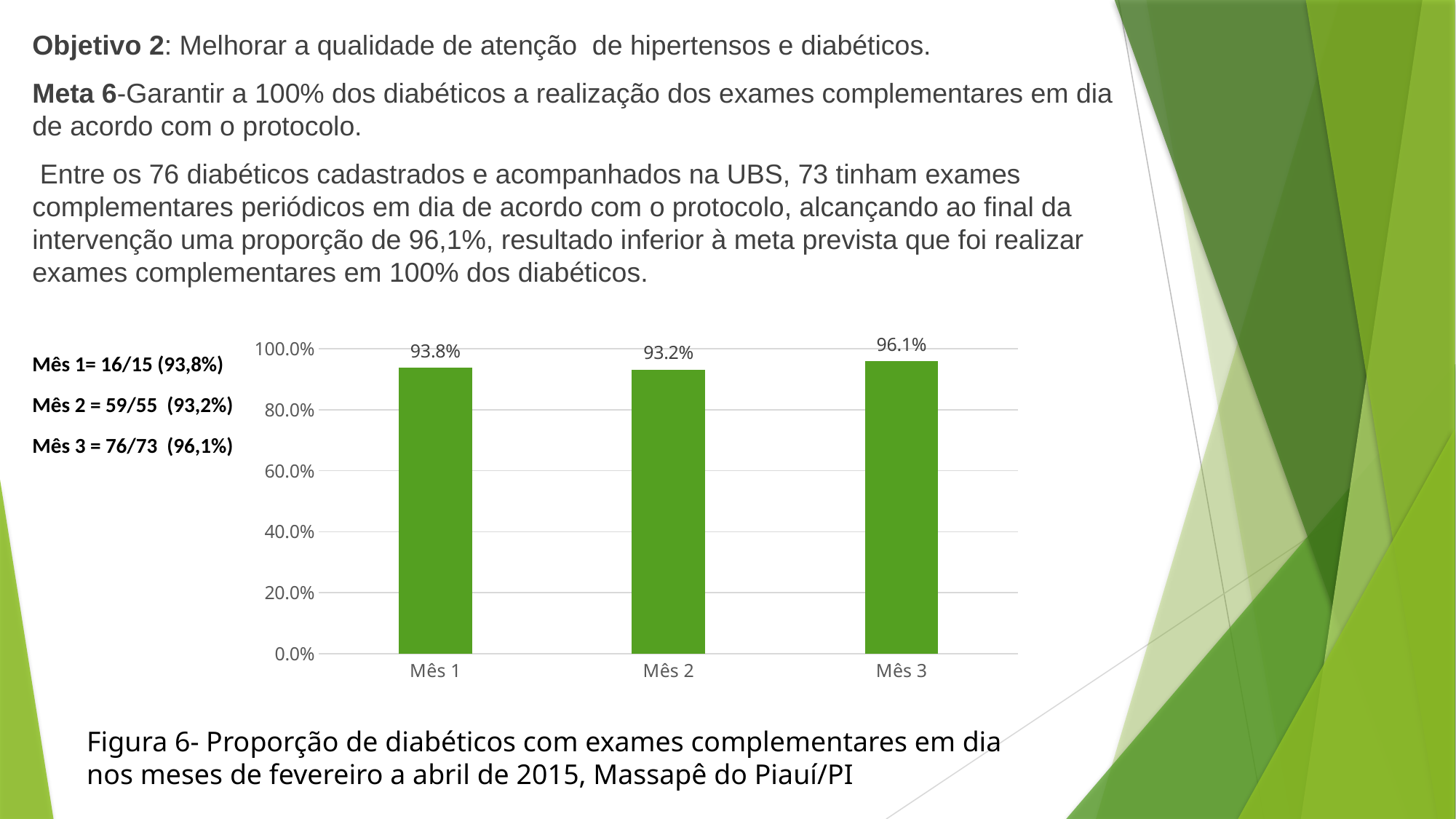
How many months are shown on the x axis? 3 What is the value for Mês 1? 93.8% What is the value for Mês 3? 96.1% What is the value for Mês 2? 93.2% Which month has the lowest value? Mês 2 Which month has the highest value? Mês 3 What is the difference between the values for Mês 3 and Mês 1? 2.3% Is the value for Mês 2 greater or less than 80.0%? greater What is the highest value shown on the y axis? 100.0% What kind of chart is shown on the slide? bar chart Which is larger, the value for Mês 3 or the value for Mês 2? Mês 3 What is the difference between the values for Mês 1 and Mês 2? 0.6%